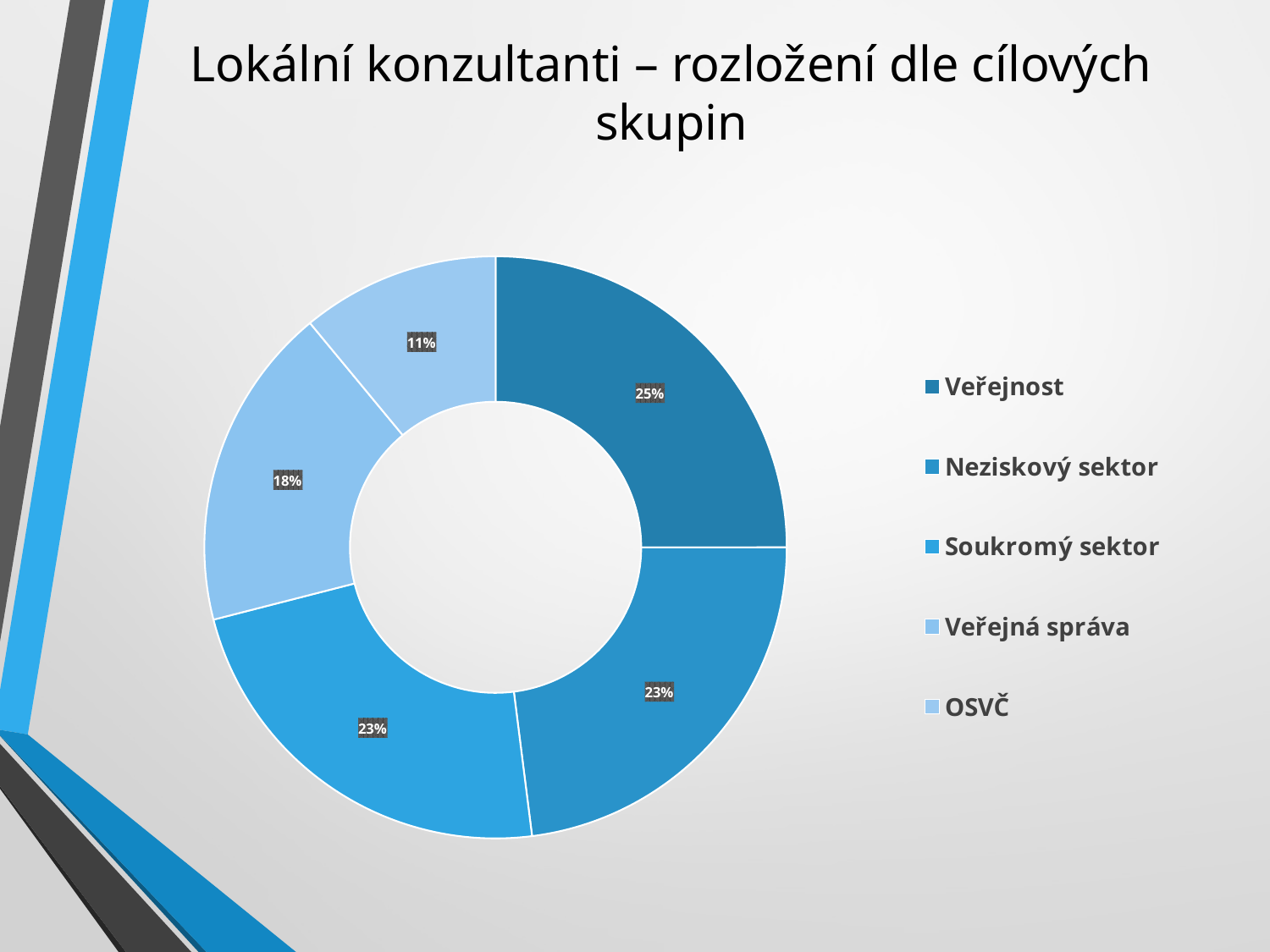
What is the difference between the shares of Veřejná správa and OSVČ? 7 percentage points By how many percentage points does Veřejnost exceed OSVČ? 14 percentage points Which category has the largest share of the chart? Veřejnost What percentage is shown for OSVČ? 11% Which is larger, the share for Veřejná správa or the share for OSVČ? Veřejná správa What share of the chart does Veřejnost account for? 25% How many categories are shown in the chart? 5 Which category has the smallest share of the chart? OSVČ What is the title of the slide containing the chart? Lokální konzultanti – rozložení dle cílových skupin What kind of chart is shown on the slide? Doughnut chart What is the value for Veřejná správa? 18% What percentage is shown for Neziskový sektor? 23%